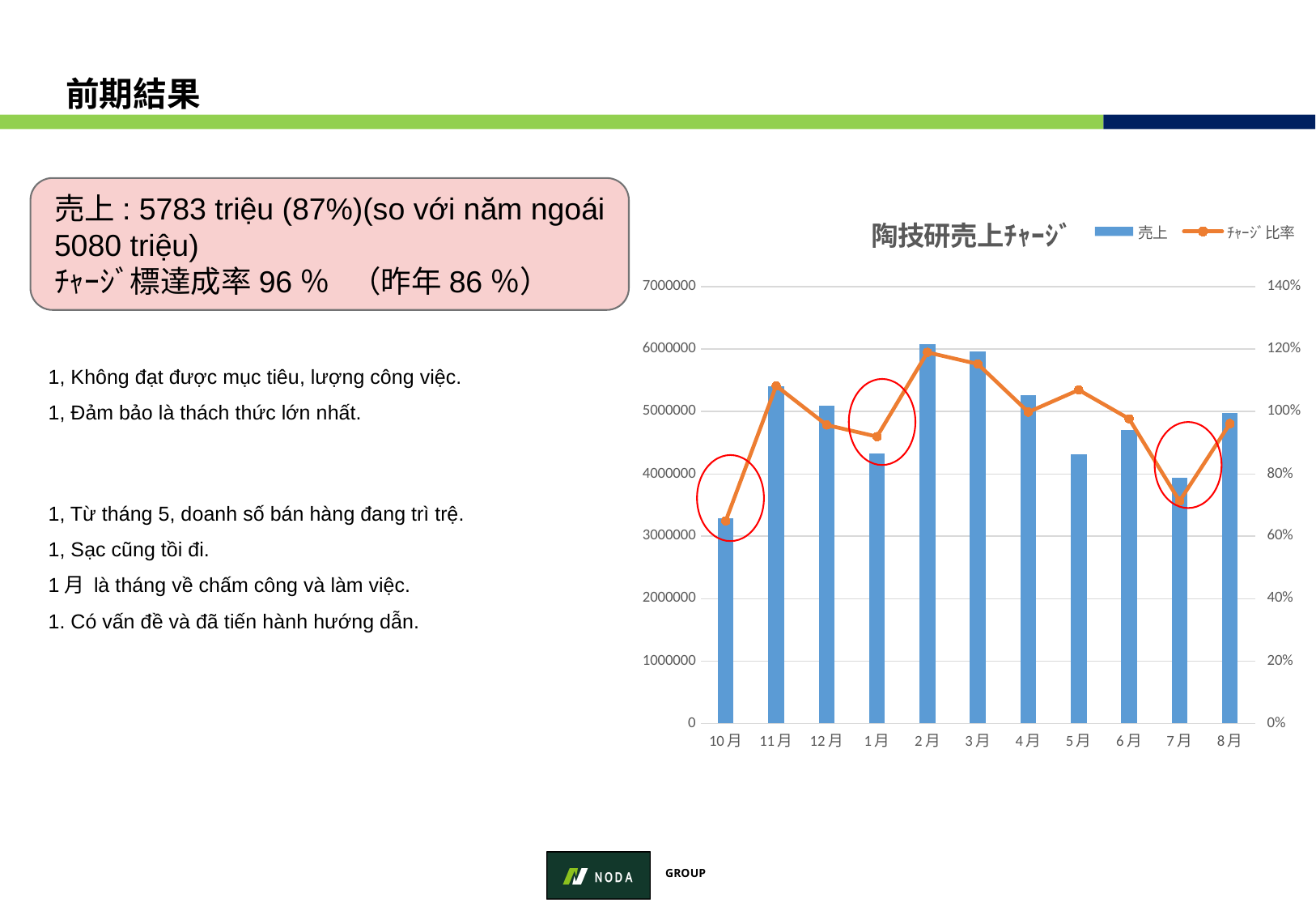
How many series does the chart legend list? 2 Is the 売上 value for 10月 greater or less than 4000000? less What kind of chart is shown on the slide? Combined bar and line chart How many months are shown on the x axis of the chart? 11 Which month has the lowest ﾁｬｰｼﾞ比率 value on the line? 10月 Which month has the highest 売上 bar? 2月 Is the 売上 value for 11月 greater or less than 5000000? greater Which month has the larger 売上 bar, 7月 or 8月? 8月 Which month has the lowest 売上 bar? 10月 What is the title of the chart on the slide? 陶技研売上ﾁｬｰｼﾞ Is the ﾁｬｰｼﾞ比率 value for 7月 greater or less than 80%? less Do the 売上 bars rise or fall from 2月 to 5月? fall